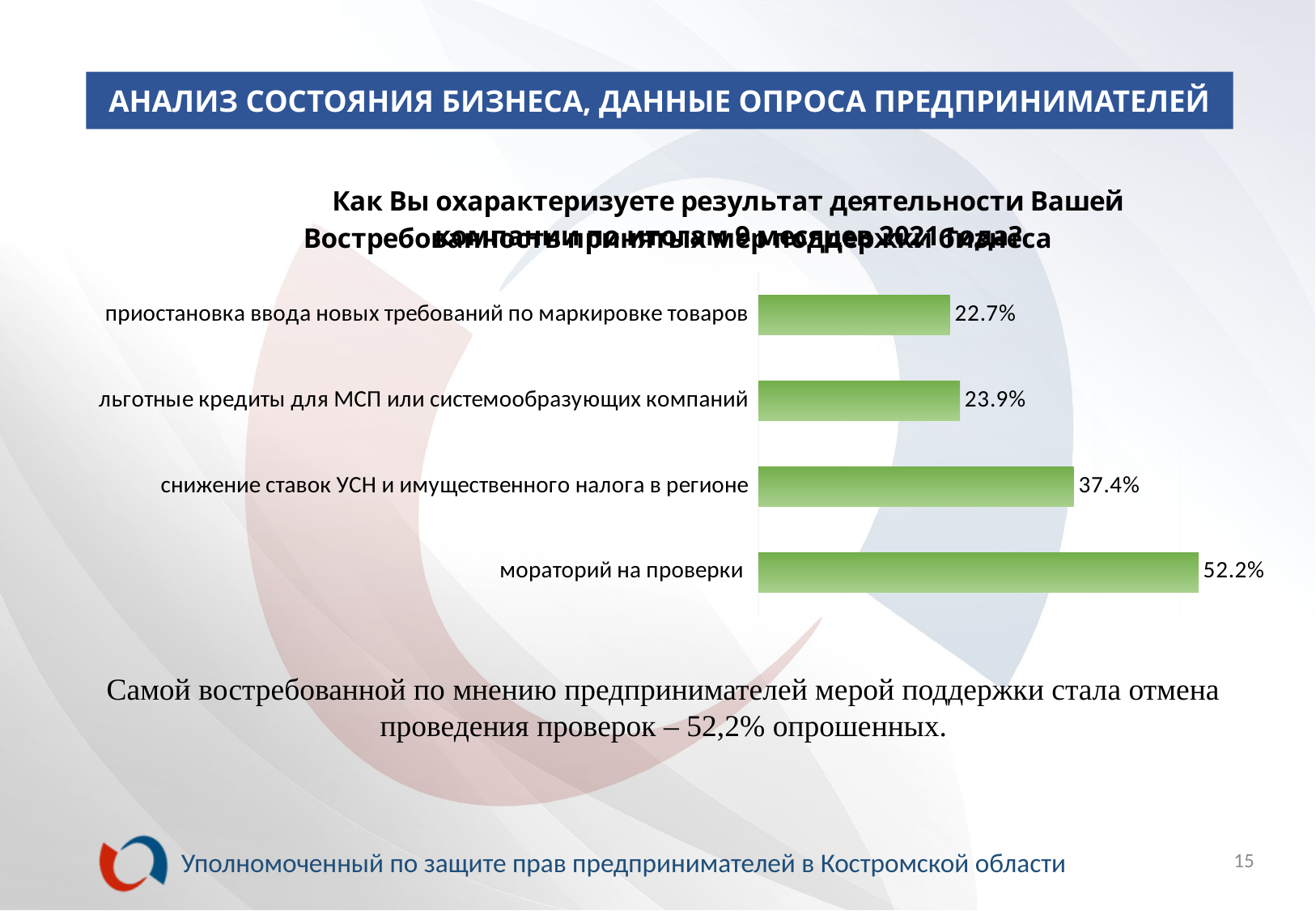
What is the difference between the values for "льготные кредиты для МСП или системообразующих компаний" and "приостановка ввода новых требований по маркировке товаров"? 1.2% What colour are the bars in the chart? green What is the value for "приостановка ввода новых требований по маркировке товаров"? 22.7% Which category has the highest value? мораторий на проверки Which is larger: the value for "снижение ставок УСН и имущественного налога в регионе" or the value for "льготные кредиты для МСП или системообразующих компаний"? снижение ставок УСН и имущественного налога в регионе Which category has the lowest value? приостановка ввода новых требований по маркировке товаров What is the value for "снижение ставок УСН и имущественного налога в регионе"? 37.4% What kind of chart is shown on the slide? bar chart How many categories are shown in the chart? 4 What is the value for "мораторий на проверки"? 52.2% What is the difference between the values for "мораторий на проверки" and "снижение ставок УСН и имущественного налога в регионе"? 14.8% What is the value for "льготные кредиты для МСП или системообразующих компаний"? 23.9%